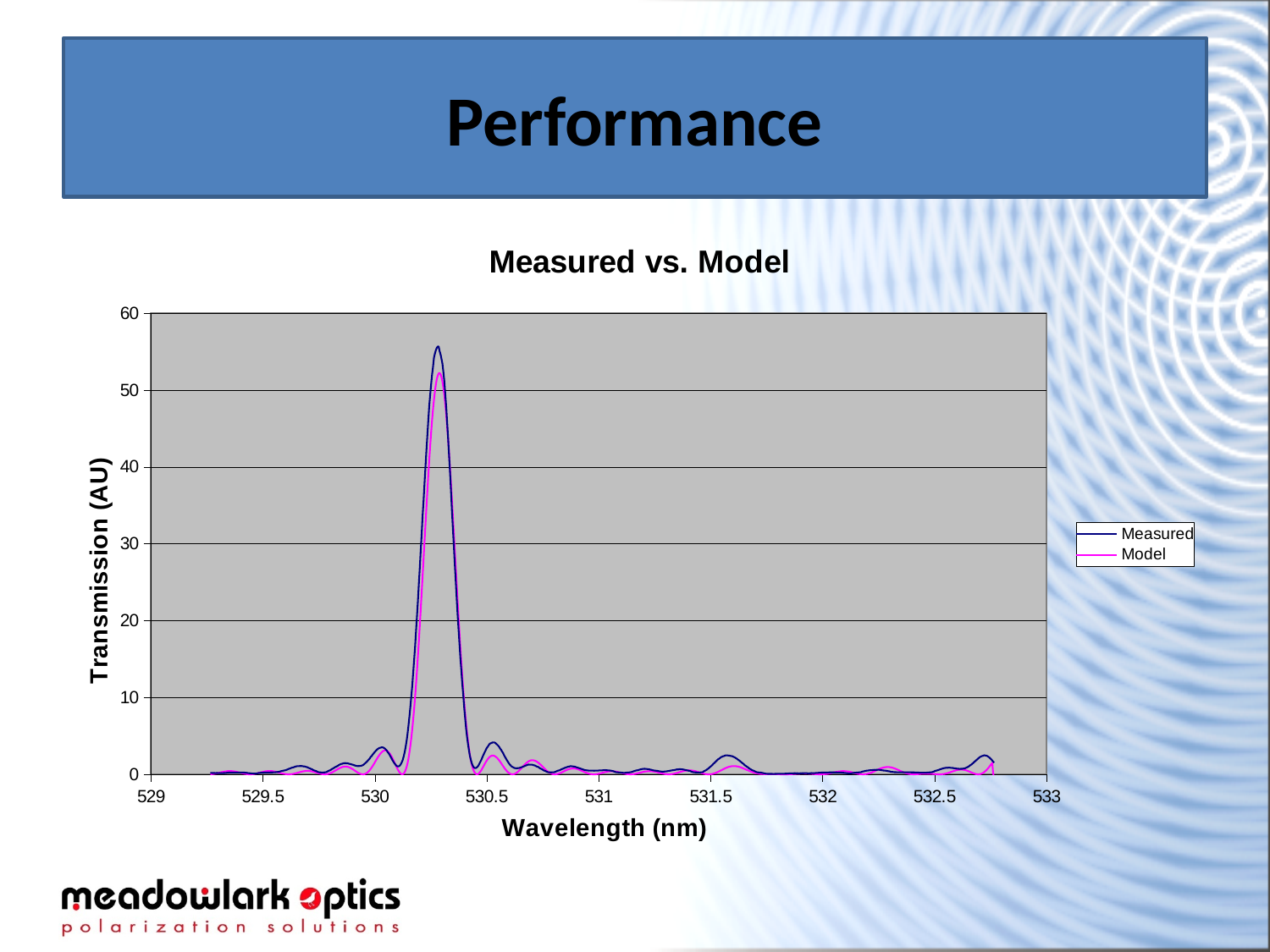
Is the peak value of the Measured series greater or less than 60? less What is the label of the x axis of the chart? Wavelength (nm) What are the two series named in the chart's legend? Measured and Model Which series reaches the higher peak transmission, Measured or Model? Measured Is the Measured transmission at 531 nm greater or less than 10? less What is the title of the chart on the slide? Measured vs. Model How many series does the chart's legend list? 2 What kind of chart is shown on the slide? line chart Is the peak value of the Measured series greater or less than 50? greater Does the Measured line rise or fall as the wavelength goes from 530.3 nm to 530.5 nm? fall